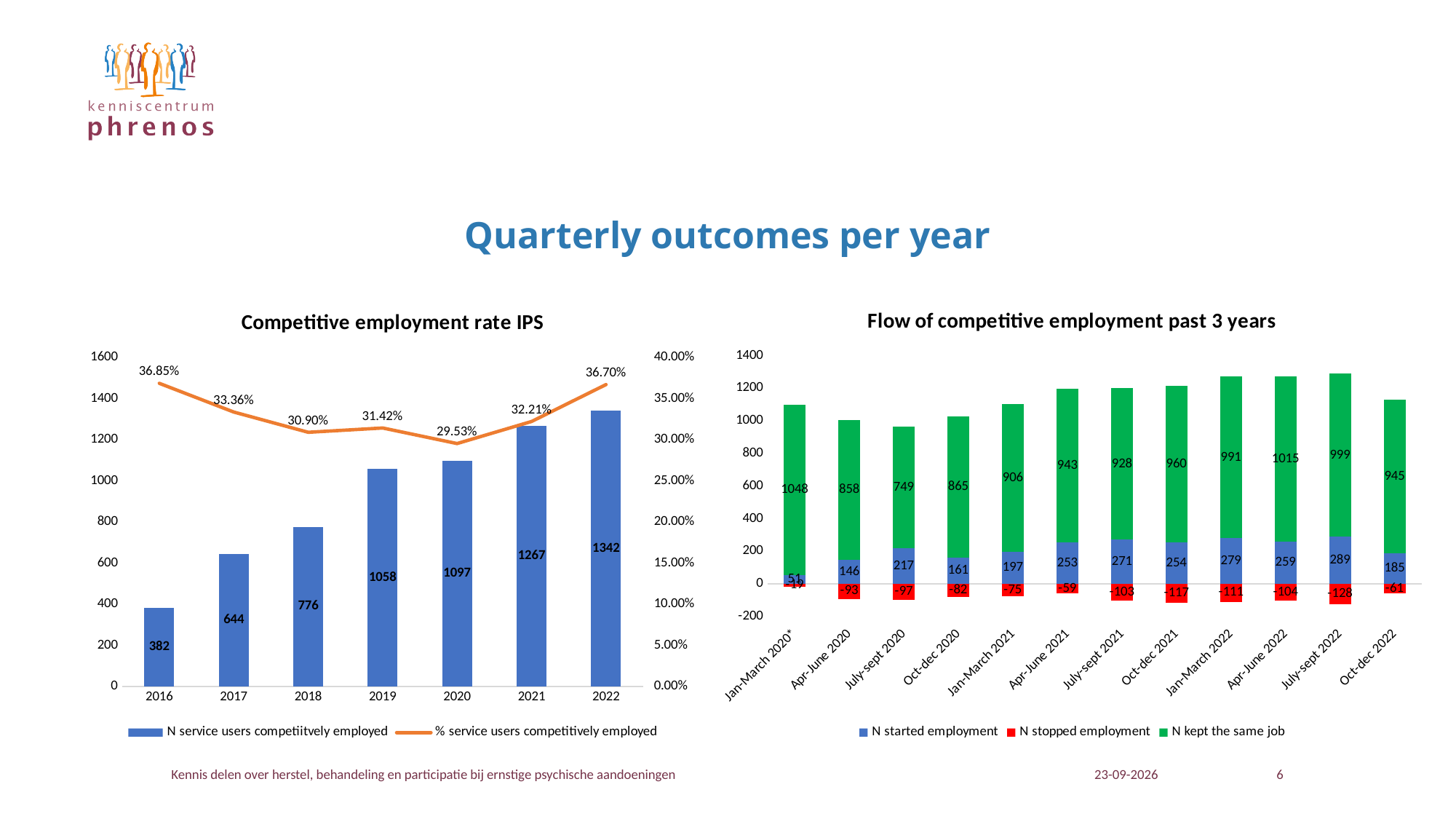
In the 'Competitive employment rate IPS' chart, how many service users were competitively employed in 2019? 1058 In the 'Flow of competitive employment past 3 years' chart, which quarter has the highest number of service users who kept the same job? Jan-March 2020 In the 'Flow of competitive employment past 3 years' chart, how many quarters are shown on the x axis? 12 In the 'Competitive employment rate IPS' chart, what is the difference between the number of service users competitively employed in 2022 and in 2021? 75 In the 'Competitive employment rate IPS' chart, what was the percentage of service users competitively employed in 2020? 29.53% In the 'Flow of competitive employment past 3 years' chart, which quarter has the lowest number of service users who started employment? Jan-March 2020 In the 'Flow of competitive employment past 3 years' chart, how many service users kept the same job in Apr-June 2022? 1015 In the 'Competitive employment rate IPS' chart, do the bars for the number of service users competitively employed rise or fall from 2016 to 2022? rise In the 'Competitive employment rate IPS' chart, which year has the lowest percentage of service users competitively employed? 2020 In the 'Competitive employment rate IPS' chart, how many series does the legend list? 2 In the 'Flow of competitive employment past 3 years' chart, what is the value for N stopped employment in July-sept 2022? -128 In the 'Flow of competitive employment past 3 years' chart, is the number who started employment larger in July-sept 2022 or in Oct-dec 2022? July-sept 2022